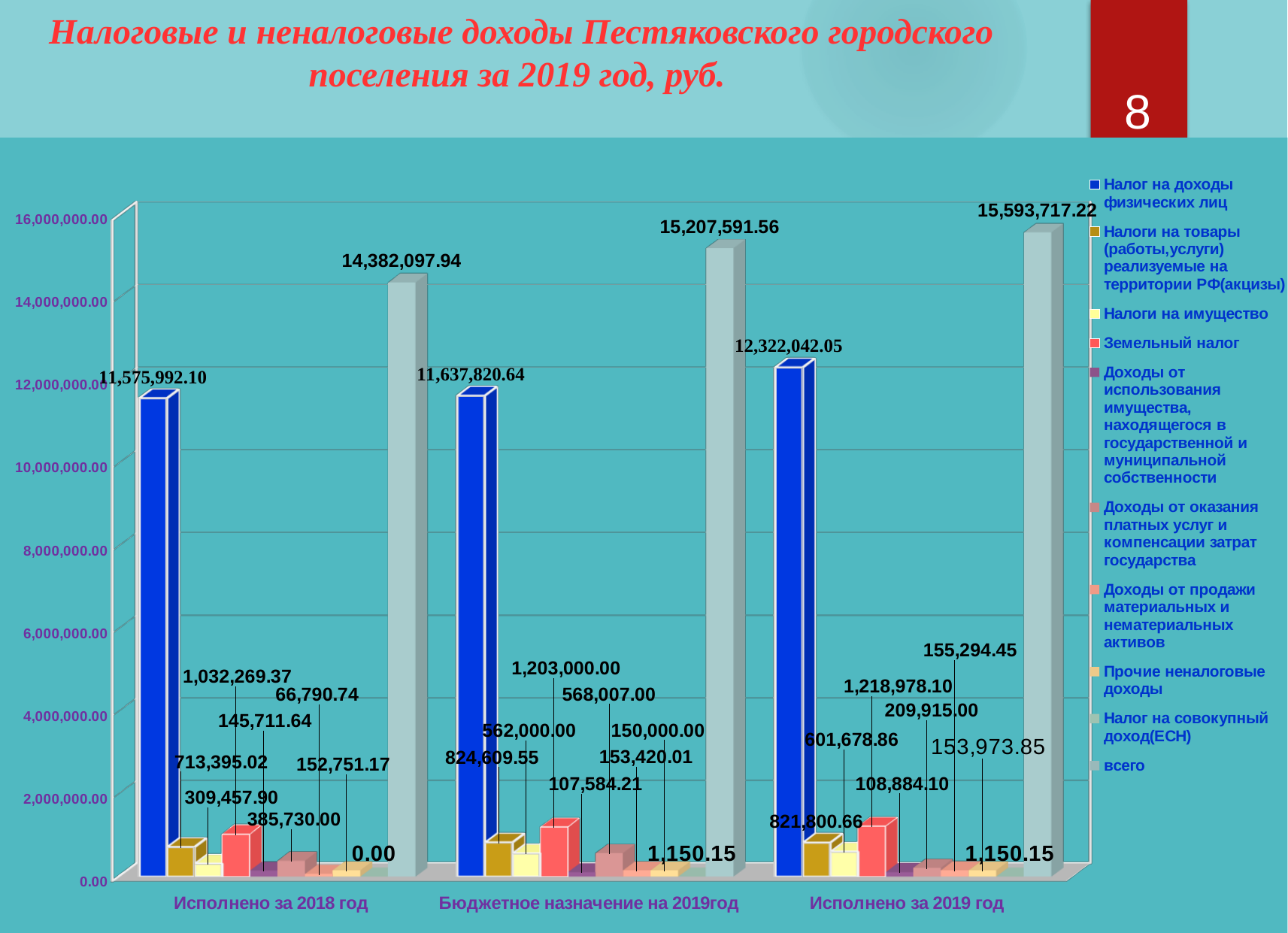
Which is larger: "Налог на доходы физических лиц" for "Исполнено за 2019 год" or for "Бюджетное назначение на 2019год"? Исполнено за 2019 год What kind of chart is shown on the slide? Bar chart How many categories are shown along the x axis of the chart? 3 What is the difference between "всего" for "Исполнено за 2019 год" and "всего" for "Исполнено за 2018 год"? 1,211,619.28 Do the values of "Налог на доходы физических лиц" rise or fall from left to right across the categories? rise Is the value of "Налог на доходы физических лиц" for "Бюджетное назначение на 2019год" greater or less than 12,000,000.00? less How many series does the chart's legend list? 10 What is the value of "Налог на доходы физических лиц" for "Исполнено за 2018 год"? 11,575,992.10 Which category has the highest value for "всего"? Исполнено за 2019 год What is the value of "всего" for "Бюджетное назначение на 2019год"? 15,207,591.56 What is the difference between "Налог на доходы физических лиц" for "Исполнено за 2019 год" and for "Бюджетное назначение на 2019год"? 684,221.41 What is the value of "всего" for "Исполнено за 2019 год"? 15,593,717.22